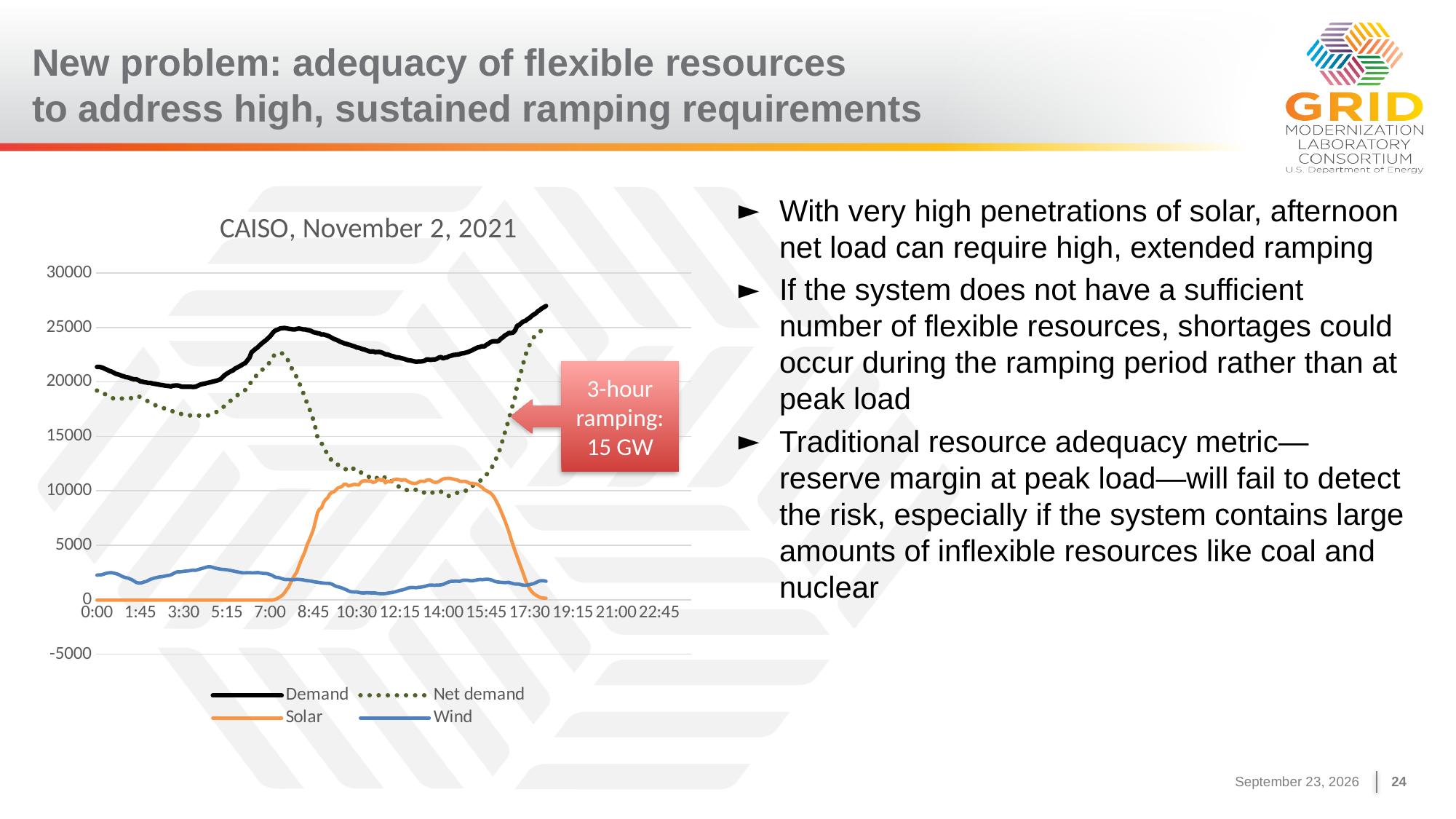
Is the value for Net demand at 14:00 greater or less than 15000? less Is the value for Solar at 12:15 greater or less than 15000? less What kind of chart is shown on the slide? Line chart At 12:15, which is larger: Demand or Net demand? Demand Is the value for Wind at 0:00 greater or less than 5000? less What is the title of the chart? CAISO, November 2, 2021 What value does the red annotation box on the chart give for 3-hour ramping? 15 GW Does the Solar series rise or fall between 7:00 and 10:30? Rises Which series has the highest values across the day? Demand How many series does the chart's legend list? 4